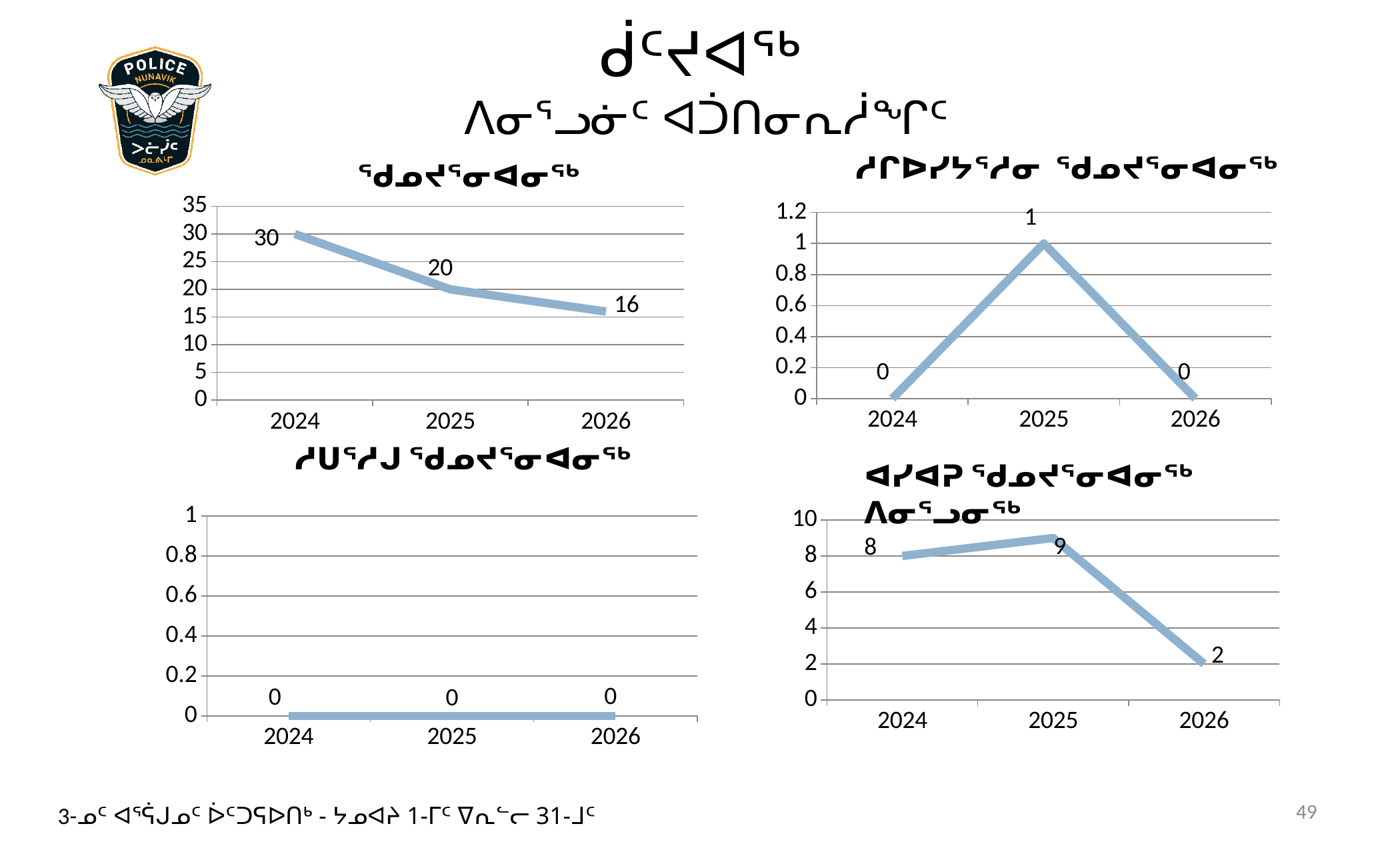
In the top-left chart, what is the value for 2024? 30 In the bottom-left chart, what is the value for 2025? 0 In the bottom-right chart, what is the value for 2026? 2 In the top-left chart, do the values rise or fall from 2024 to 2026? fall In the top-left chart, which year has the lowest value? 2026 What kind of chart is the bottom-right chart? line chart In the top-left chart, what is the difference between the 2024 and 2025 values? 10 In the top-right chart, what is the value for 2025? 1 In the bottom-right chart, which year has the highest value? 2025 In the top-left chart, what is the value for 2026? 16 In the top-right chart, which year has the highest value? 2025 In the bottom-right chart, which is larger, the value for 2024 or the value for 2026? 2024